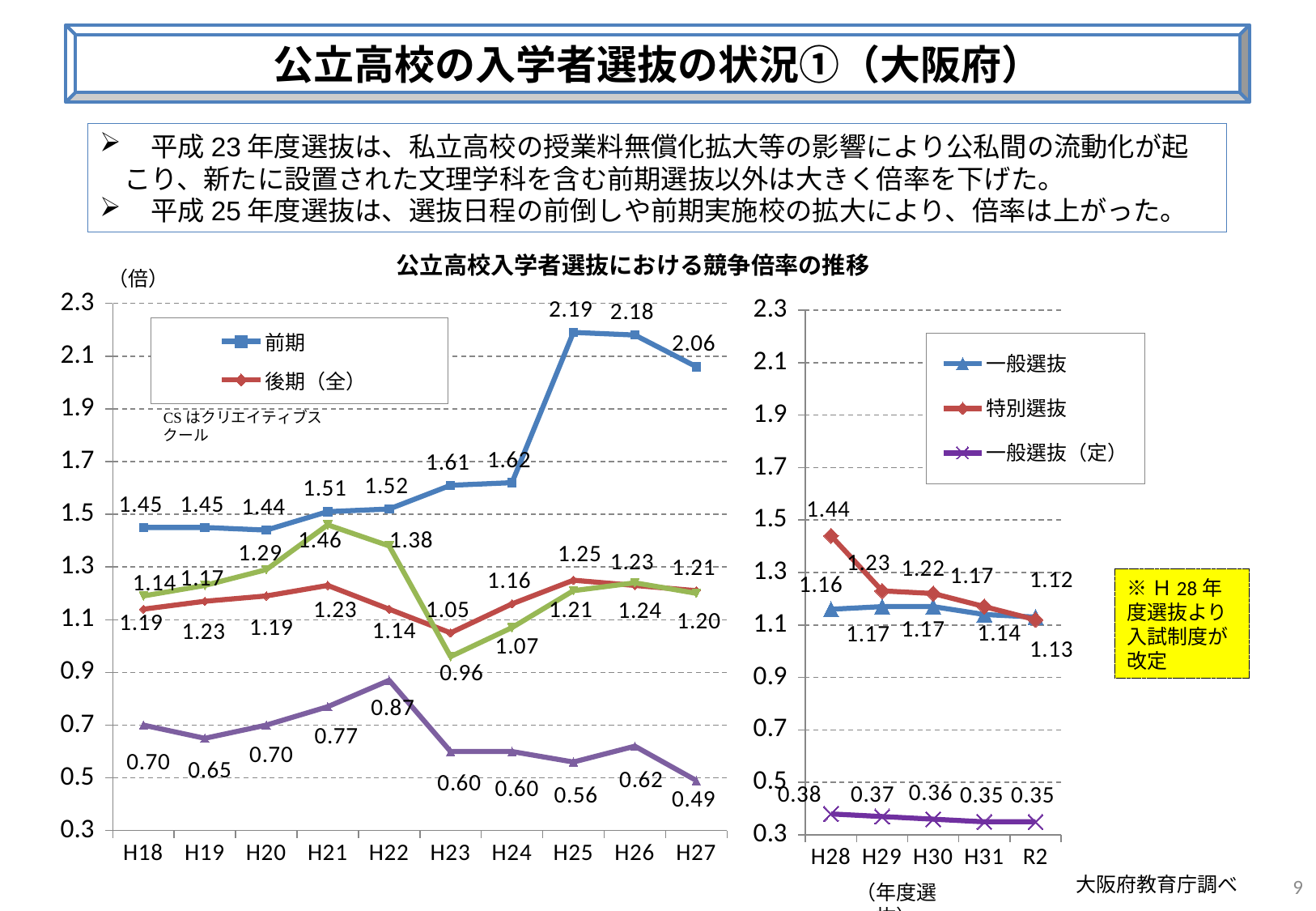
In the left chart (H18–H27), how many years are shown on the x axis? 10 In the right chart (H28–R2), does the 特別選抜 value rise or fall from H28 to R2? fall In the right chart (H28–R2), how many series does the legend list? 3 In the left chart (H18–H27), what is the value of 前期 for H27? 2.06 In the right chart (H28–R2), which is larger at H28: 特別選抜 or 一般選抜? 特別選抜 In the right chart (H28–R2), what is the value of 一般選抜（定） for R2? 0.35 In the left chart (H18–H27), what is the value of 前期 for H25? 2.19 In the right chart (H28–R2), what is the value of 特別選抜 for H28? 1.44 In the left chart (H18–H27), what is the difference between the 前期 values for H25 and H24? 0.57 In the left chart (H18–H27), in which year is the 前期 value highest? H25 In the left chart (H18–H27), is the 前期 value for H18 greater or less than 1.3? greater What kind of chart is used on this slide? line chart